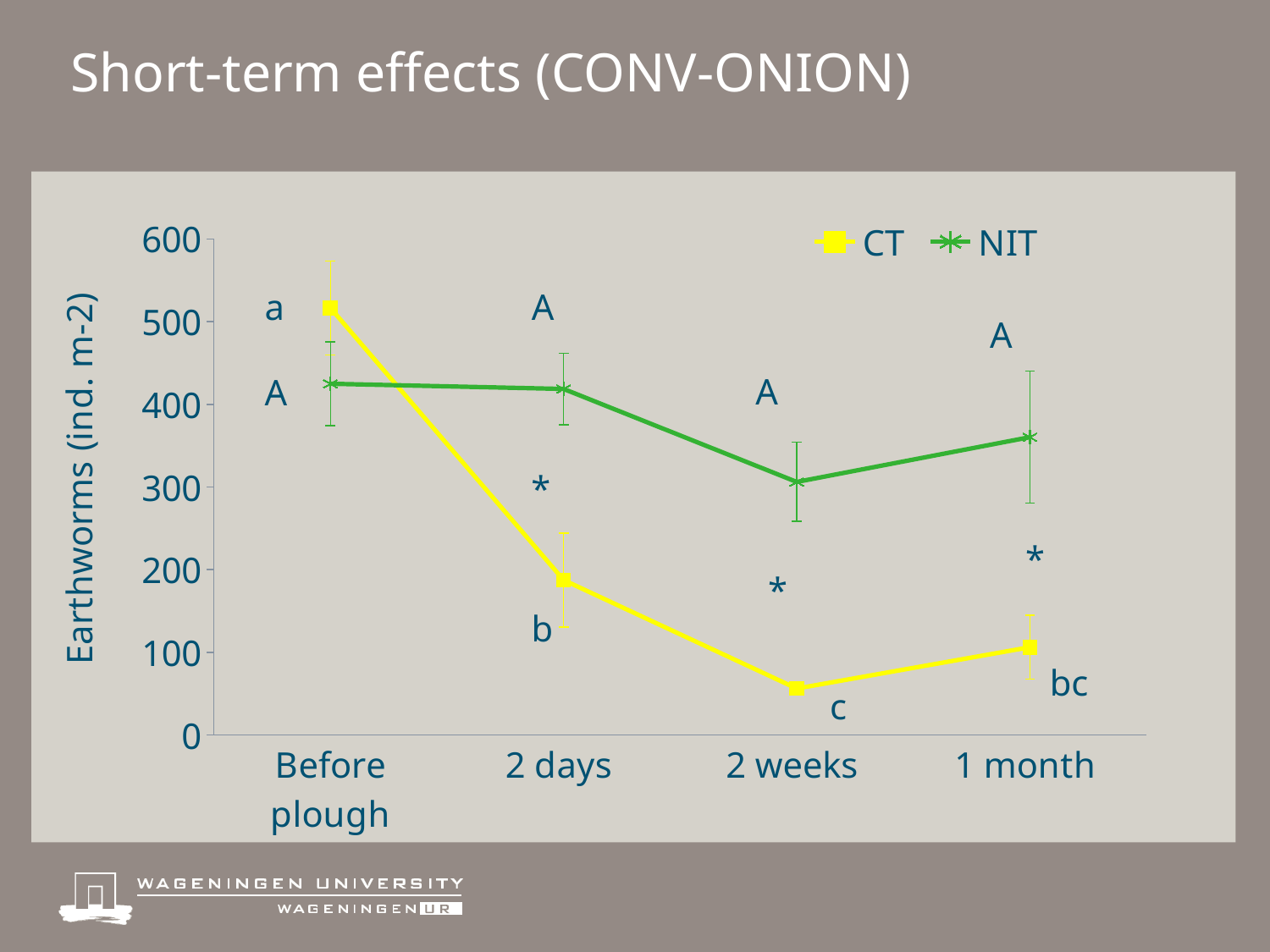
At which time point is the CT series highest? Before plough What is the label of the y axis? Earthworms (ind. m-2) At 2 weeks, which series has the larger value, CT or NIT? NIT Which series is plotted in yellow? CT Is the CT value at 2 weeks greater or less than 100? less Is the NIT value at 1 month greater or less than 400? less At which time point is the CT series lowest? 2 weeks How many series does the legend list? 2 Before plough, which series has the larger value, CT or NIT? CT How many time points are plotted along the x axis? 4 At which time point is the NIT series lowest? 2 weeks What kind of chart is shown on the slide? line chart